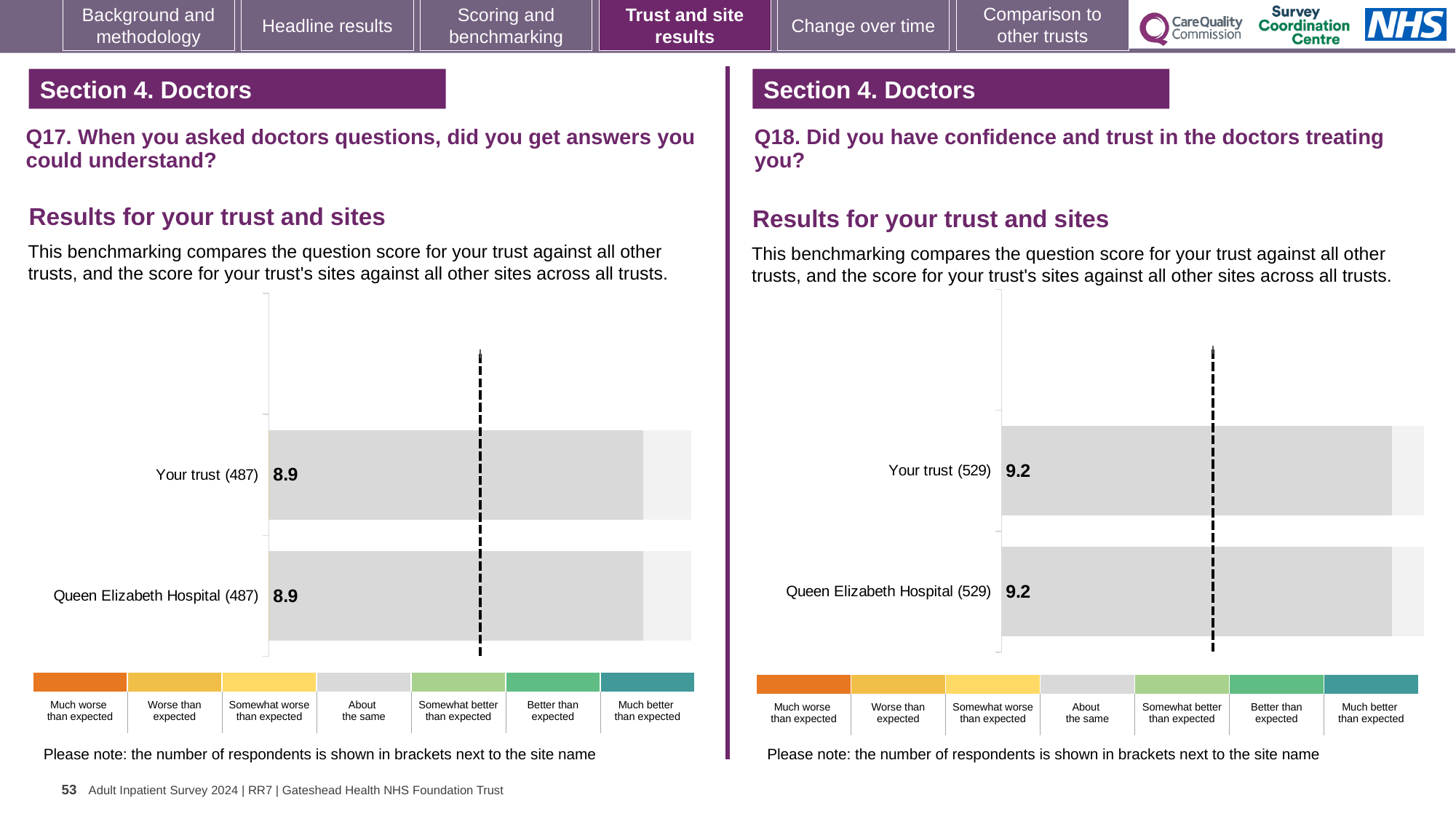
On the Q18 chart (right), what is the score for Queen Elizabeth Hospital? 9.2 On the Q18 chart (right), what is the score for Your trust? 9.2 On the Q17 chart (left), what is the difference between the score for Your trust and the score for Queen Elizabeth Hospital? 0 On the Q17 chart (left), what is the score for Queen Elizabeth Hospital? 8.9 What kind of chart is used on the Q17 chart (left)? Bar chart Is the score for Your trust on the Q18 chart (right) larger or smaller than the score for Your trust on the Q17 chart (left)? Larger How many bars are plotted on the Q17 chart (left)? 2 How many bars are plotted on the Q18 chart (right)? 2 On the Q18 chart (right), how many respondents are shown in brackets next to Queen Elizabeth Hospital? 529 On the Q17 chart (left), how many respondents are shown in brackets next to Your trust? 487 On the Q17 chart (left), what is the score for Your trust? 8.9 On the Q18 chart (right), what is the difference between the score for Your trust and the score for Queen Elizabeth Hospital? 0